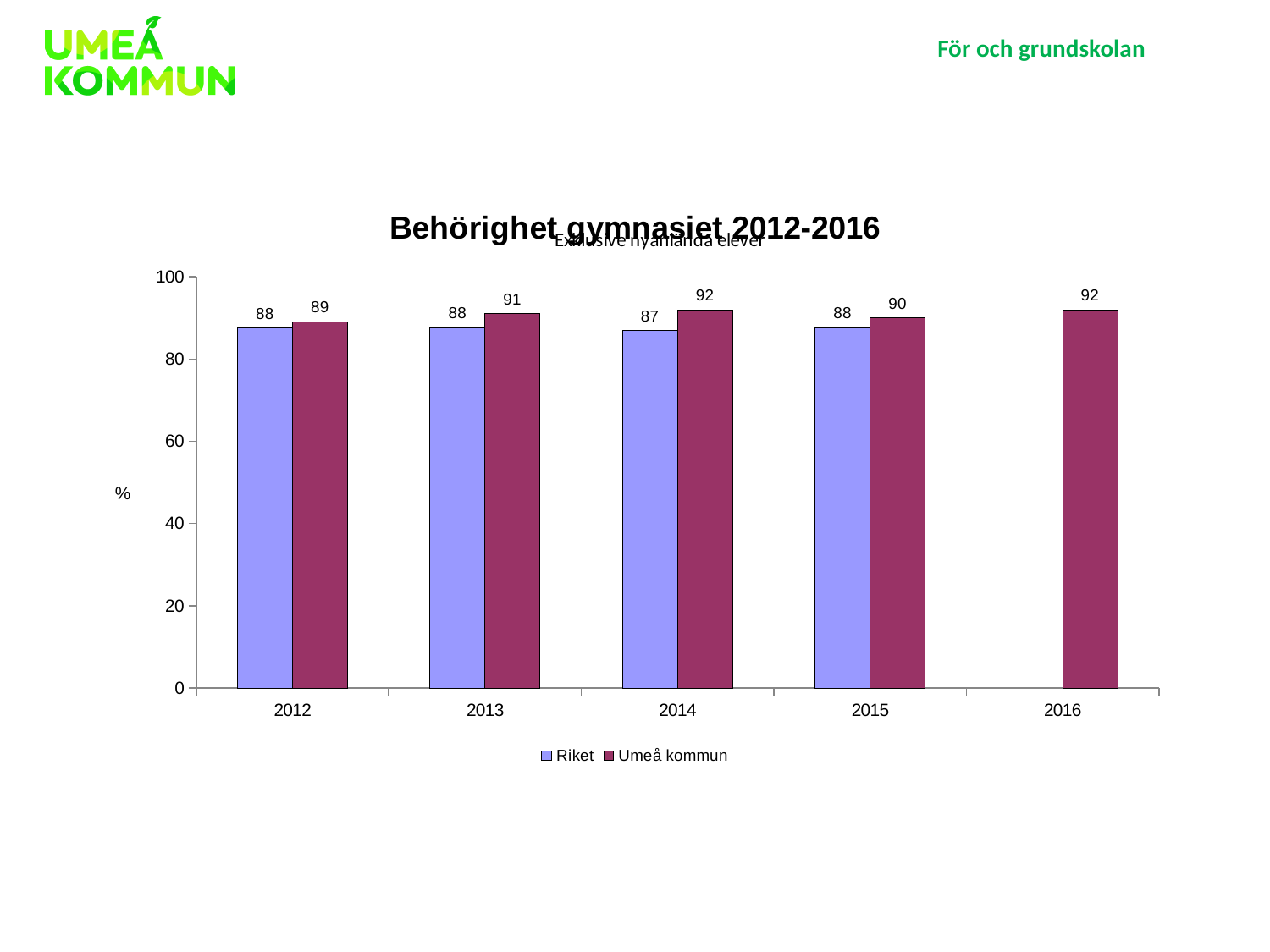
How many years are shown on the x axis? 5 Is the value for Riket in 2012 greater or less than 80? greater Which is larger in 2015, Riket or Umeå kommun? Umeå kommun What is the value for Riket in 2014? 87 What kind of chart is shown? bar chart How many series does the legend list? 2 What is the value for Umeå kommun in 2016? 92 In which year is the Riket value lowest? 2014 What is the difference between Umeå kommun and Riket in 2014? 5 What is the value for Umeå kommun in 2013? 91 In which year is the Umeå kommun value lowest? 2012 What is the title of the chart? Behörighet gymnasiet 2012-2016